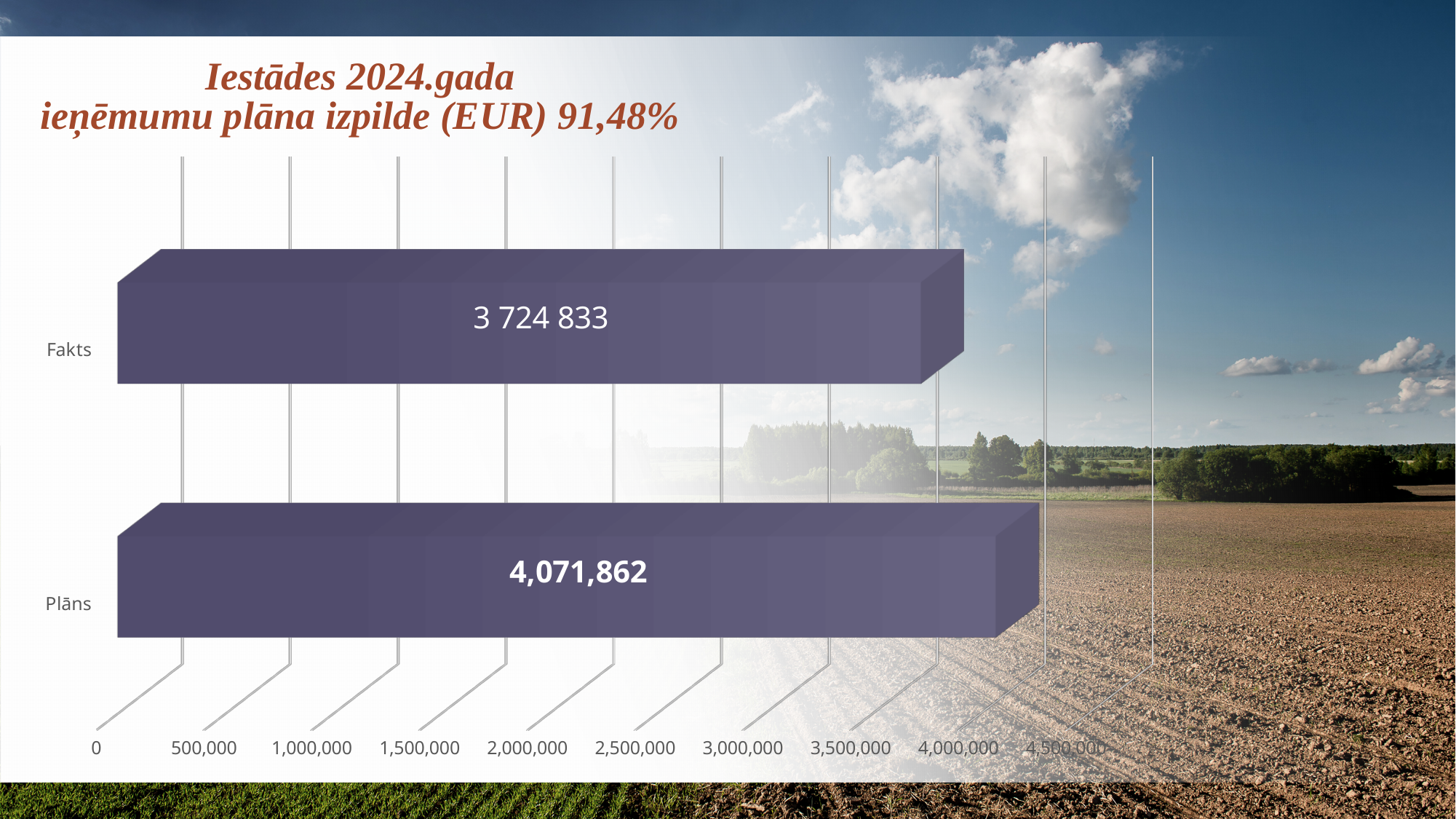
Is the value for Plāns greater or less than 4,500,000? less What is the value for Plāns? 4,071,862 Which category has the higher value, Fakts or Plāns? Plāns What kind of chart is shown on the slide? Bar chart What is the maximum value shown on the horizontal axis? 4,500,000 Which category has the highest value? Plāns How many categories are shown in the chart? 2 Which category has the lowest value? Fakts What percentage of plan fulfilment is stated in the chart title? 91,48% Is the value for Fakts greater or less than 3,500,000? greater What is the difference between the Plāns value and the Fakts value? 347,029 What is the value for Fakts? 3 724 833